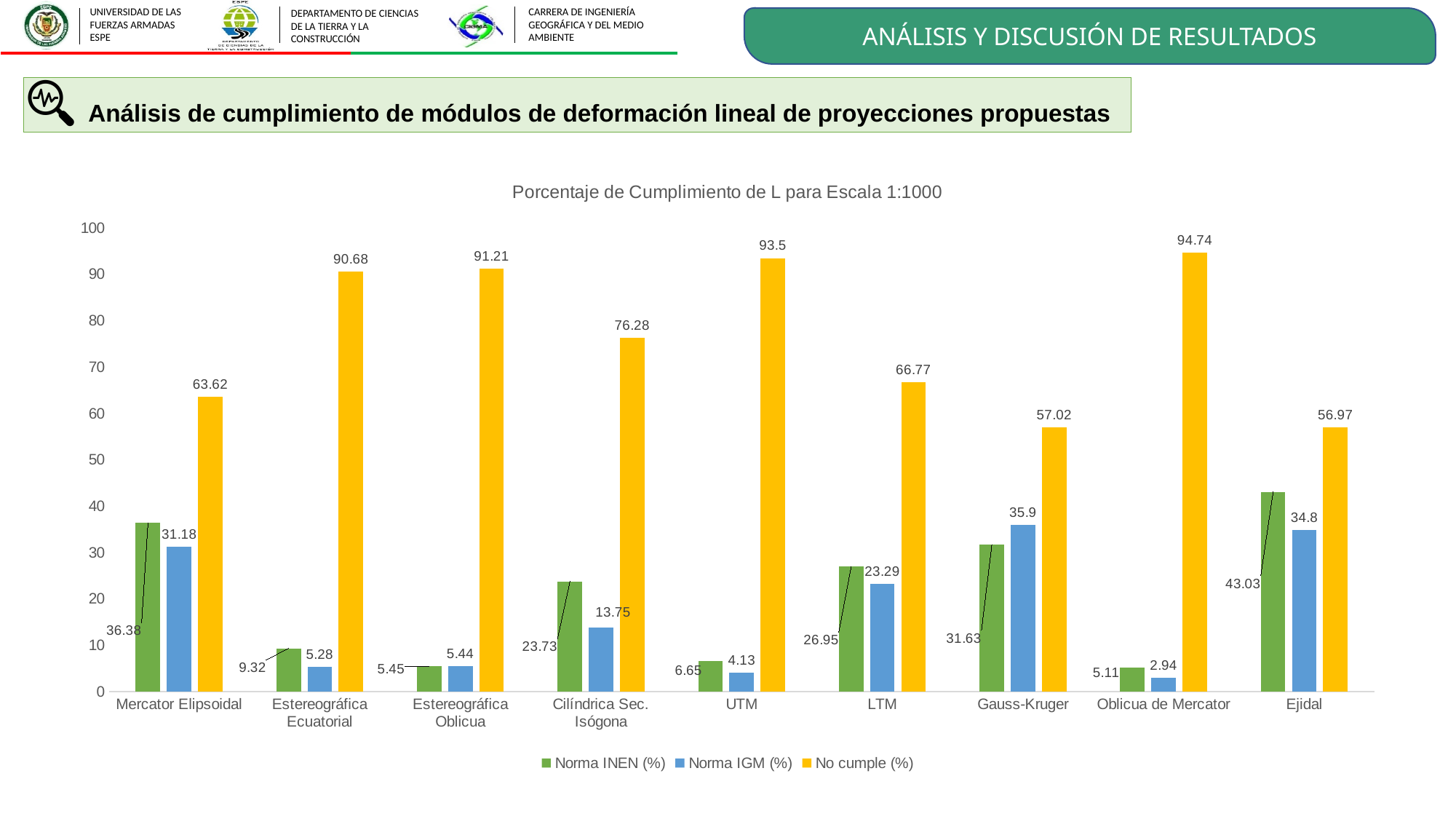
How many projection categories are shown on the x axis? 9 What is the value of Norma IGM (%) for Gauss-Kruger? 35.9 How many series does the legend list? 3 Which is larger for Gauss-Kruger: Norma INEN (%) or Norma IGM (%)? Norma IGM (%) What is the value of Norma INEN (%) for Ejidal? 43.03 What is the title of the chart? Porcentaje de Cumplimiento de L para Escala 1:1000 What kind of chart is shown on the slide? Bar chart Which category has the lowest Norma IGM (%) value? Oblicua de Mercator What is the difference between the No cumple (%) values for Estereográfica Oblicua and Estereográfica Ecuatorial? 0.53 Which category has the highest No cumple (%) value? Oblicua de Mercator What is the value of No cumple (%) for UTM? 93.5 Is the No cumple (%) value for LTM greater or less than 60? greater